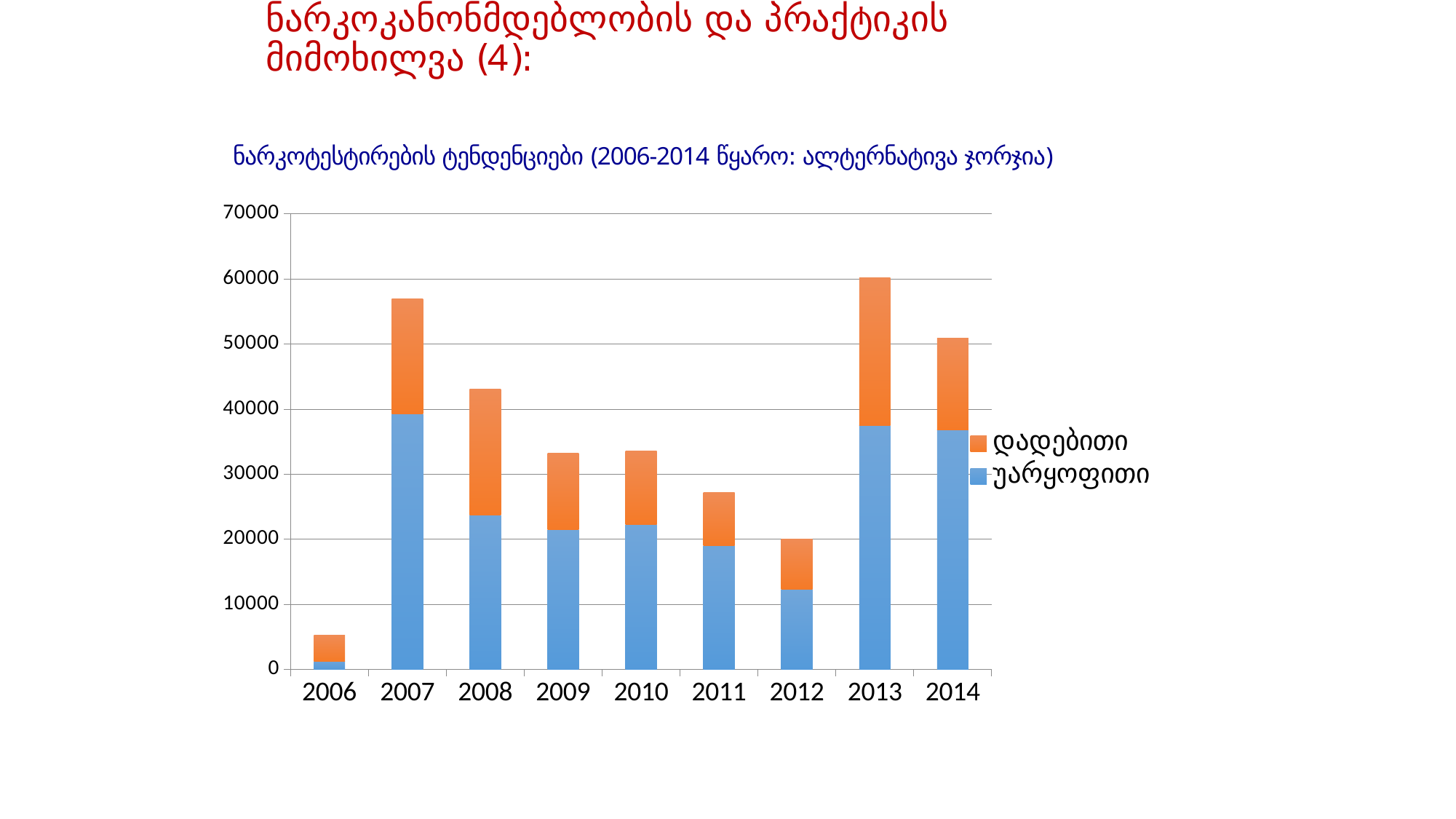
Which year has the lowest total bar in the chart? 2006 How many years are shown on the x axis of the chart? 9 Is the total bar for 2007 greater or less than 50000? greater Is the უარყოფითი (blue) value for 2008 greater or less than 20000? greater Which year has the larger total bar, 2011 or 2012? 2011 Which year has the highest total bar in the chart? 2013 Do the total bars rise or fall from 2007 to 2012? fall Which year has the larger total bar, 2007 or 2008? 2007 Which series is shown in orange in the chart? დადებითი What kind of chart is shown on the slide? stacked bar chart Is the total bar for 2006 greater or less than 10000? less How many series does the chart legend list? 2